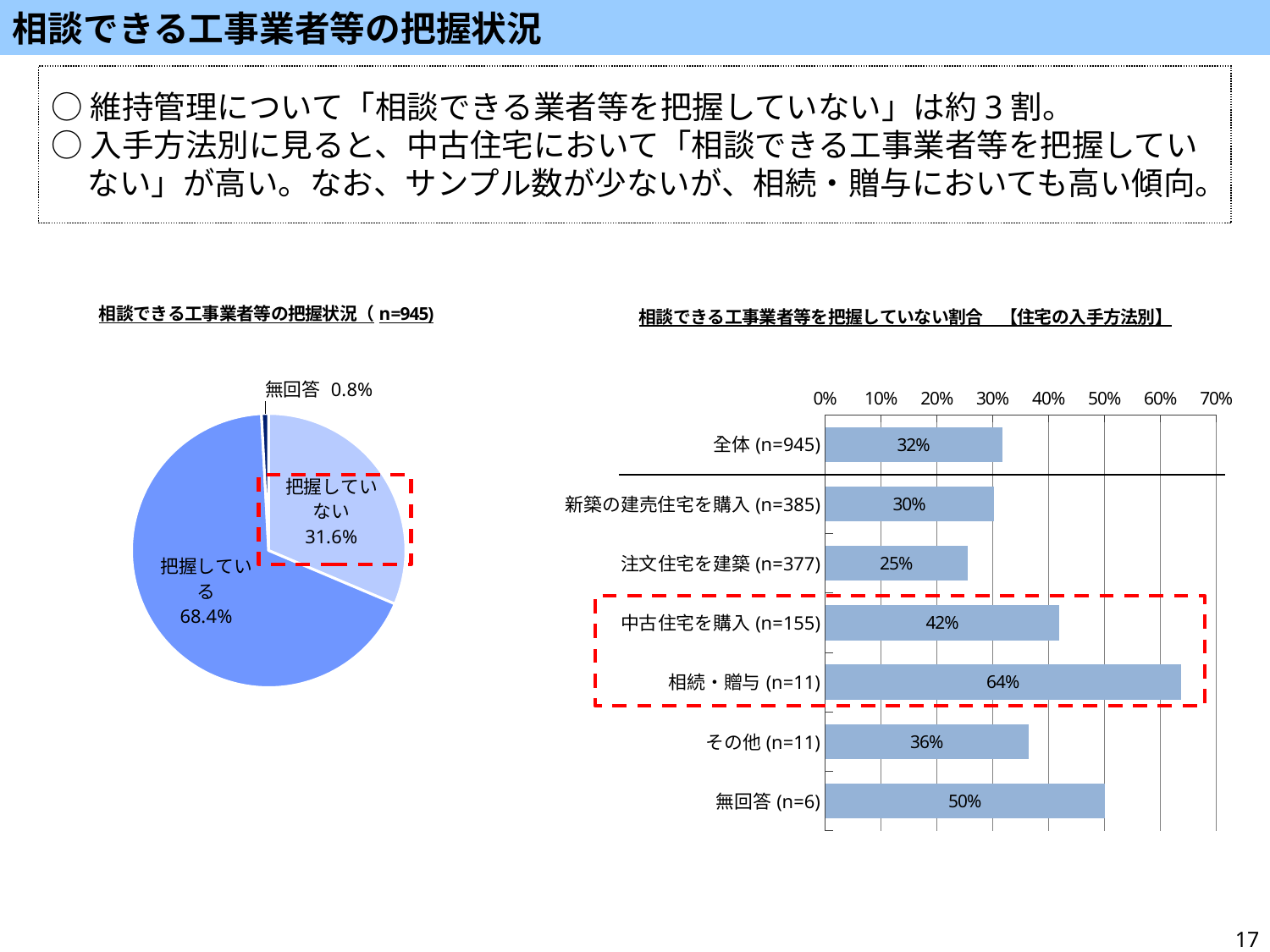
In the pie chart on the left, what is the value for 無回答? 0.8% In the pie chart on the left (相談できる工事業者等の把握状況), what is the value for 把握していない? 31.6% In the pie chart on the left, what is the value for 把握している? 68.4% In the bar chart on the right (相談できる工事業者等を把握していない割合), what is the value for 中古住宅を購入 (n=155)? 42% In the pie chart on the left, how many slices are there? 3 In the bar chart on the right, which category has the highest value? 相続・贈与 (n=11) In the bar chart on the right, what is the difference between 相続・贈与 (n=11) and 中古住宅を購入 (n=155)? 22% In the bar chart on the right, which category has the lowest value? 注文住宅を建築 (n=377) In the bar chart on the right, what is the value for 全体 (n=945)? 32% What kind of chart is the chart on the right? bar chart In the bar chart on the right, which is larger: 新築の建売住宅を購入 (n=385) or その他 (n=11)? その他 (n=11) In the pie chart on the left, which slice is the largest? 把握している